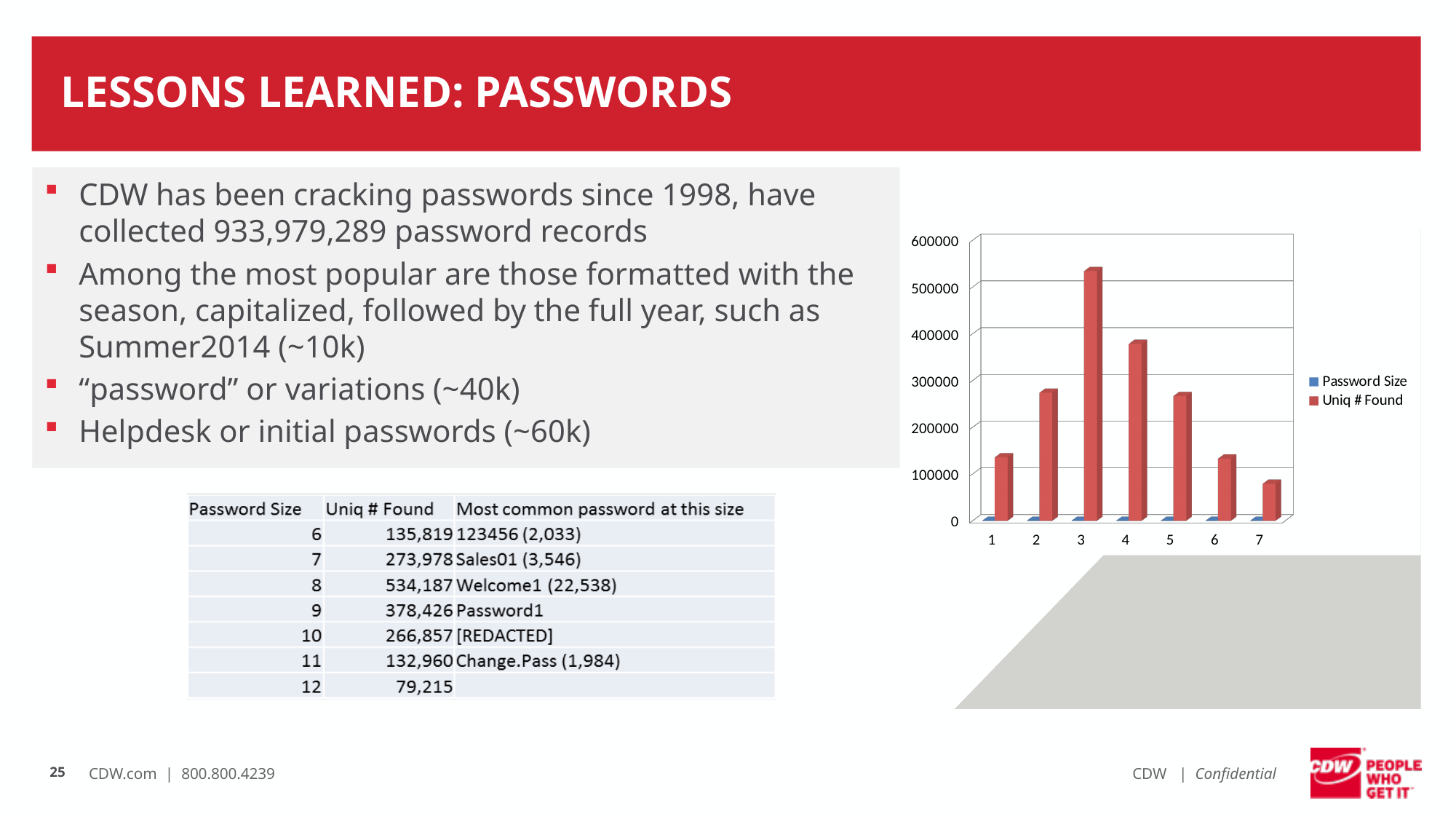
Which category has the highest Uniq # Found bar in the chart? 3 Do the Uniq # Found bars rise or fall from category 3 to category 7? fall Is the Uniq # Found value for category 7 greater or less than 100000? less What kind of chart is shown on the slide? bar chart Is the Uniq # Found value for category 1 greater or less than 200000? less Which has a larger Uniq # Found bar, category 2 or category 6? category 2 Is the Uniq # Found value for category 3 greater or less than 500000? greater How many series does the chart legend list? 2 What colour are the Uniq # Found bars in the chart? red How many categories are shown on the x axis of the chart? 7 Which category has the lowest Uniq # Found bar in the chart? 7